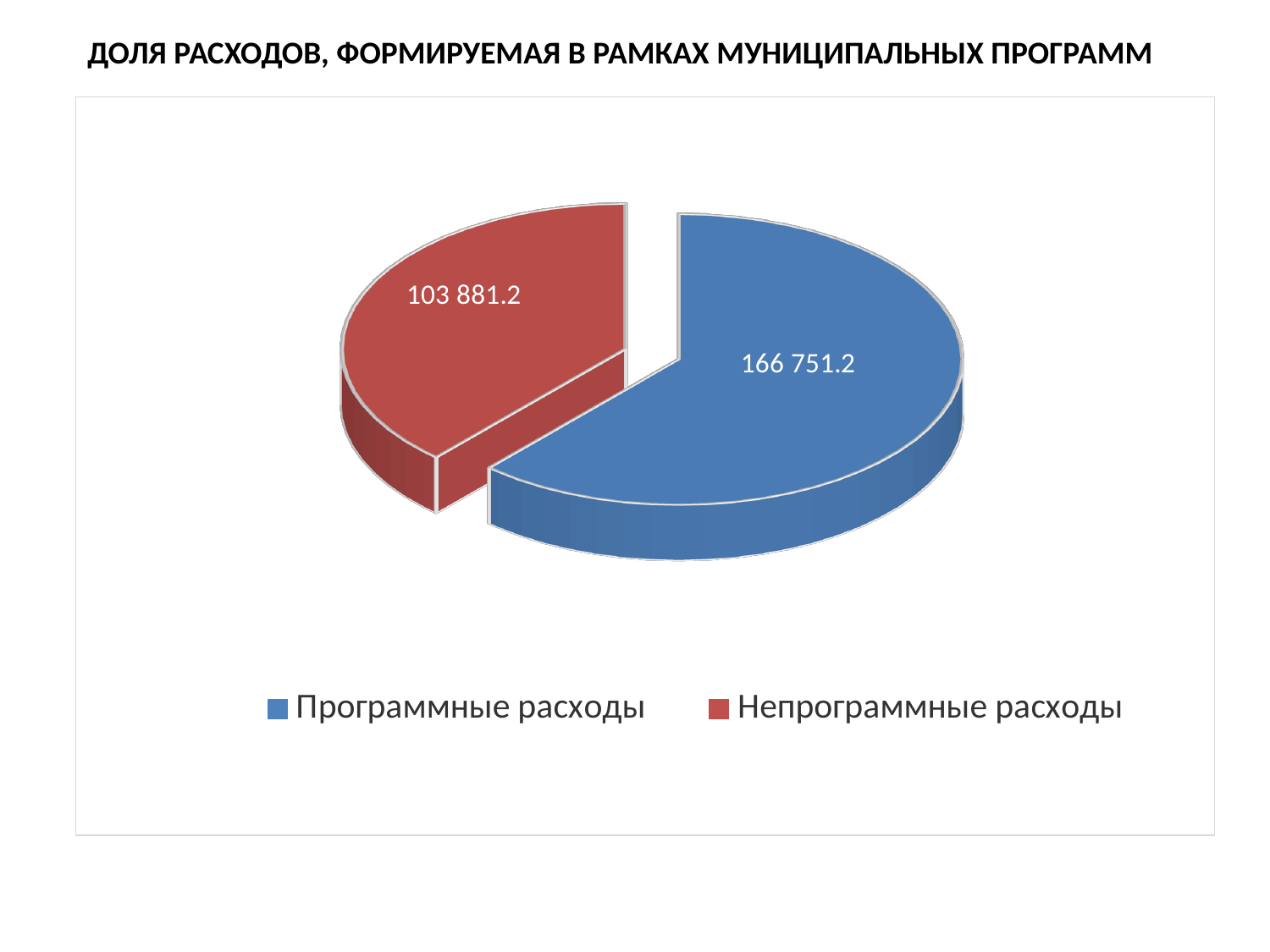
What is the value for Непрограммные расходы? 103 881.2 Which is larger: Программные расходы or Непрограммные расходы? Программные расходы What type of chart is shown on the slide? Pie chart Which category has the largest slice of the pie? Программные расходы How many entries does the legend list? 2 What is the total of the two slices in the pie chart? 270 632.4 What is the value for Программные расходы? 166 751.2 Which category has the smallest slice of the pie? Непрограммные расходы What colour is the slice for Непрограммные расходы? Red What is the title of the slide above the chart? ДОЛЯ РАСХОДОВ, ФОРМИРУЕМАЯ В РАМКАХ МУНИЦИПАЛЬНЫХ ПРОГРАММ What is the difference between Программные расходы and Непрограммные расходы? 62 870.0 How many slices does the pie chart have? 2